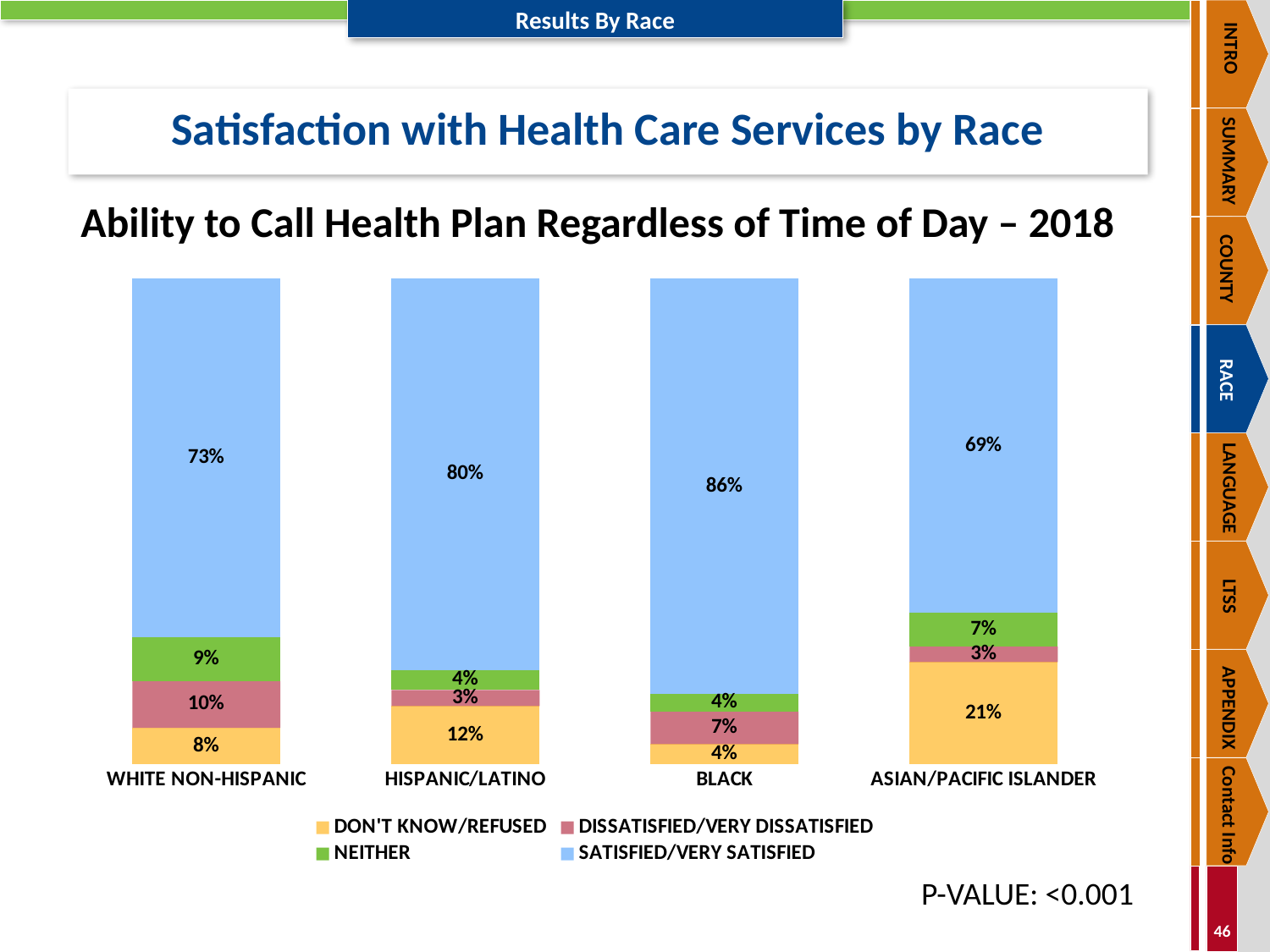
Which group has a larger Don't Know/Refused share, Hispanic/Latino or Black? Hispanic/Latino What kind of chart is shown on the slide? Stacked bar chart Which race group has the highest Satisfied/Very Satisfied percentage? Black How many series does the legend list? 4 What percentage of Asian/Pacific Islander respondents answered Don't Know/Refused? 21% How many race groups are shown on the chart? 4 What is the total of the Neither and Dissatisfied/Very Dissatisfied segments for Asian/Pacific Islander respondents? 10% Which race group has the lowest Satisfied/Very Satisfied percentage? Asian/Pacific Islander What percentage of White Non-Hispanic respondents were Dissatisfied/Very Dissatisfied? 10% What is the difference in Satisfied/Very Satisfied percentage between Black and White Non-Hispanic respondents? 13 percentage points What p-value is reported on the slide? <0.001 What percentage of Black respondents were Satisfied/Very Satisfied with the ability to call the health plan regardless of time of day? 86%